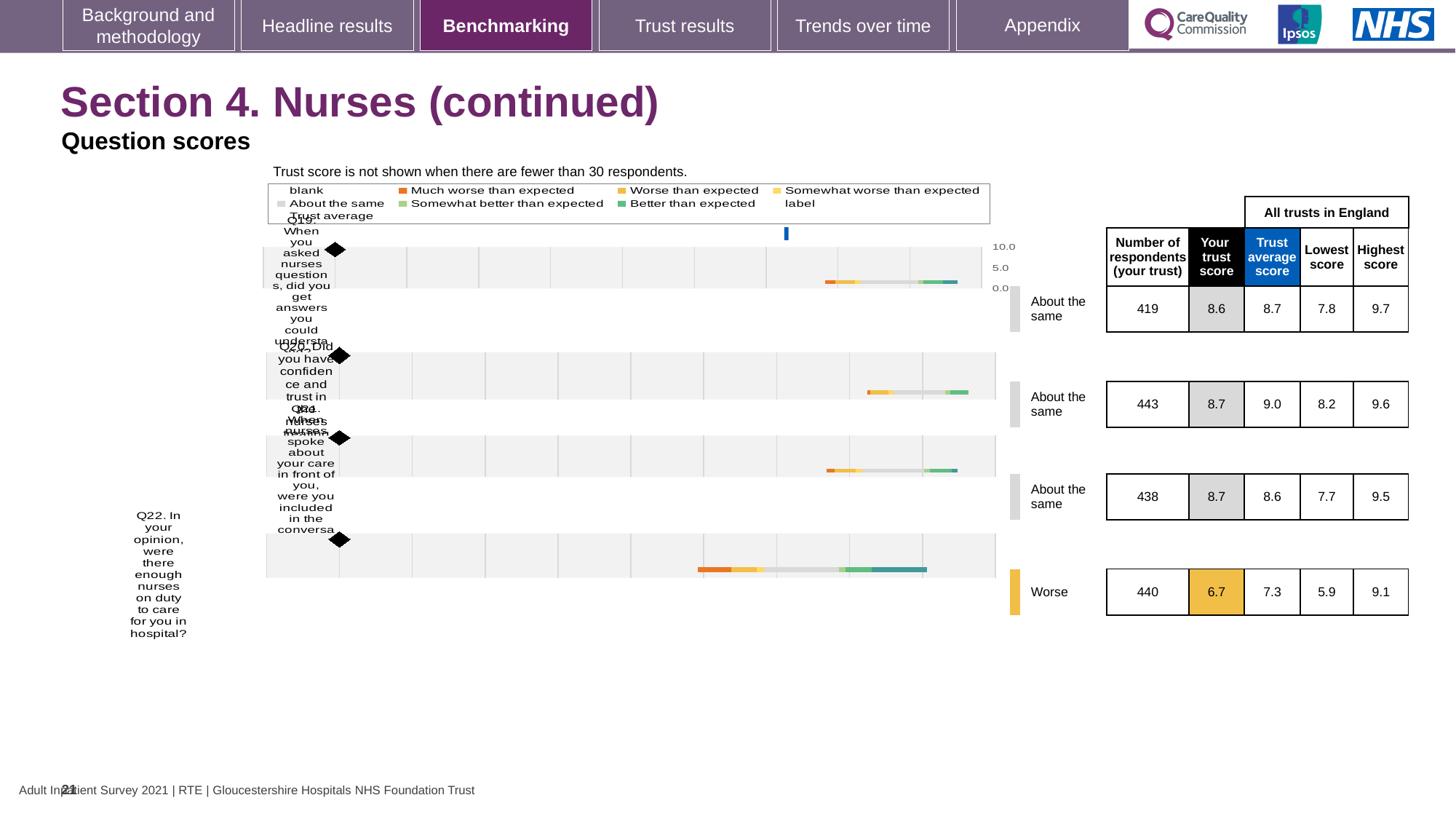
Which question is rated 'Worse' rather than 'About the same'? Q22 What is the highest score across all trusts in England for Q19? 9.7 For Q19, which is larger: your trust score or the trust average score? Trust average score What kind of chart is used to show the question scores on this slide? bar chart What is the difference between the highest and lowest scores for Q20? 1.4 What is the difference between the trust average score and your trust score for Q22? 0.6 How many questions (categories) are plotted in the chart? 4 What is the 'Your trust score' for Q22 (were there enough nurses on duty)? 6.7 What is the lowest score across all trusts in England for Q22? 5.9 Which question has the lowest 'Your trust score'? Q22 How many respondents are shown for Q19? 419 How many respondents are shown for Q20 (confidence and trust in nurses)? 443